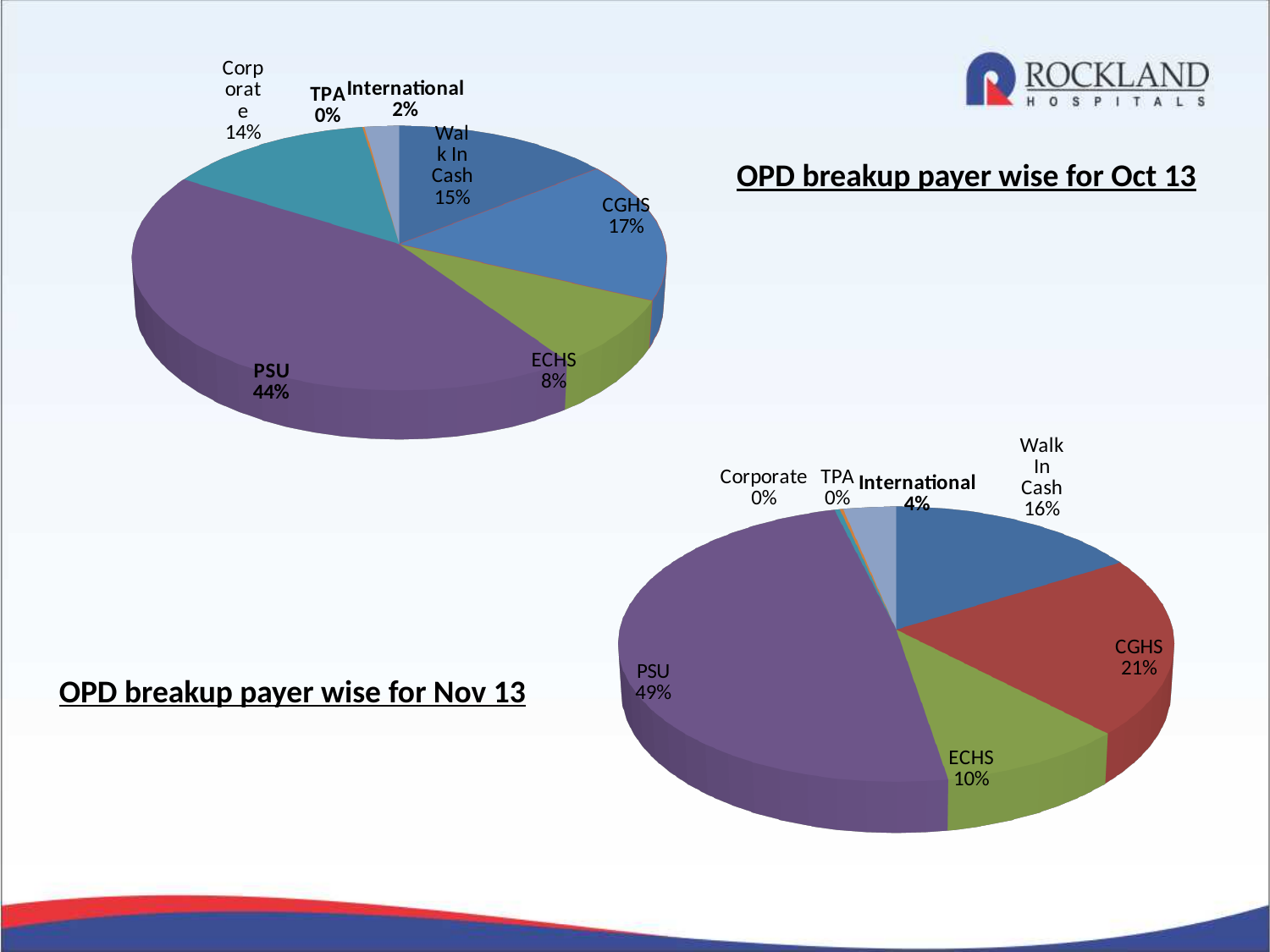
In the 'OPD breakup payer wise for Oct 13' chart, which payer has the largest share? PSU What type of chart is used for 'OPD breakup payer wise for Oct 13'? Pie chart In the 'OPD breakup payer wise for Oct 13' chart, what share does Corporate have? 14% In the 'OPD breakup payer wise for Nov 13' chart, what share does CGHS have? 21% In the 'OPD breakup payer wise for Oct 13' chart, what is the difference between the CGHS share and the ECHS share? 9% In the 'OPD breakup payer wise for Oct 13' chart, which is larger, the Walk In Cash share or the CGHS share? CGHS In the 'OPD breakup payer wise for Nov 13' chart, which payer has the largest share? PSU In the 'OPD breakup payer wise for Nov 13' chart, what share does International have? 4% In the 'OPD breakup payer wise for Oct 13' chart, what share does PSU have? 44% In the 'OPD breakup payer wise for Nov 13' chart, what share does ECHS have? 10% How many payer categories are shown in the 'OPD breakup payer wise for Nov 13' chart? 7 In the 'OPD breakup payer wise for Nov 13' chart, what is the difference between the PSU share and the Walk In Cash share? 33%